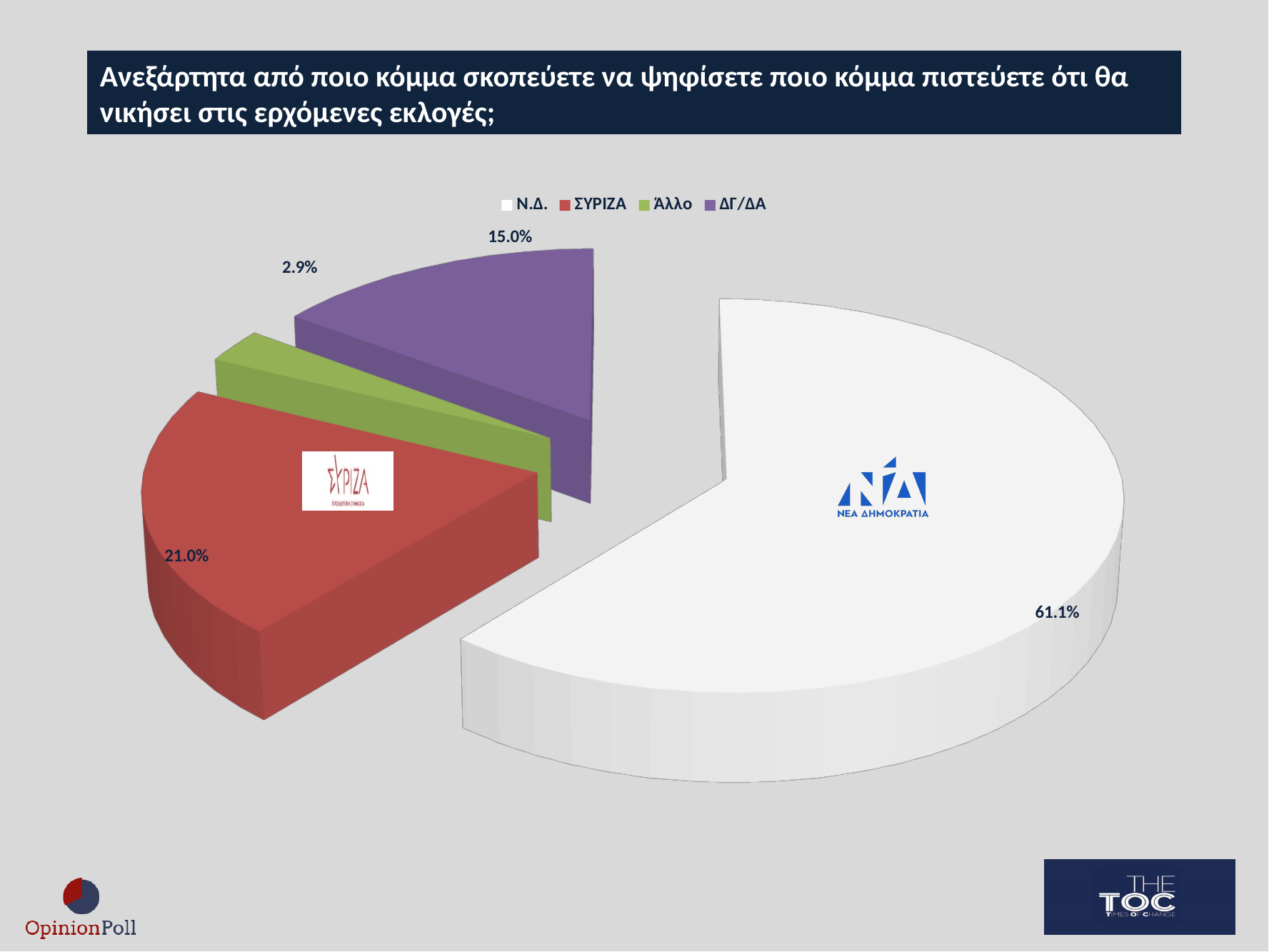
What percentage of the pie is the ΔΓ/ΔΑ slice? 15.0% Which category has the smallest slice of the pie? Άλλο What percentage of the pie is the Άλλο slice? 2.9% Which category has the largest slice of the pie? Ν.Δ. What kind of chart is shown on the slide? Pie chart What percentage of the pie is the ΣΥΡΙΖΑ slice? 21.0% What percentage of the pie is the Ν.Δ. slice? 61.1% What colour is the ΔΓ/ΔΑ slice in the pie chart? Purple What is the difference in percentage points between the Ν.Δ. slice and the ΣΥΡΙΖΑ slice? 40.1 How many slices does the pie chart have? 4 What is the difference in percentage points between the ΣΥΡΙΖΑ slice and the ΔΓ/ΔΑ slice? 6.0 Which slice is larger, ΔΓ/ΔΑ or Άλλο? ΔΓ/ΔΑ